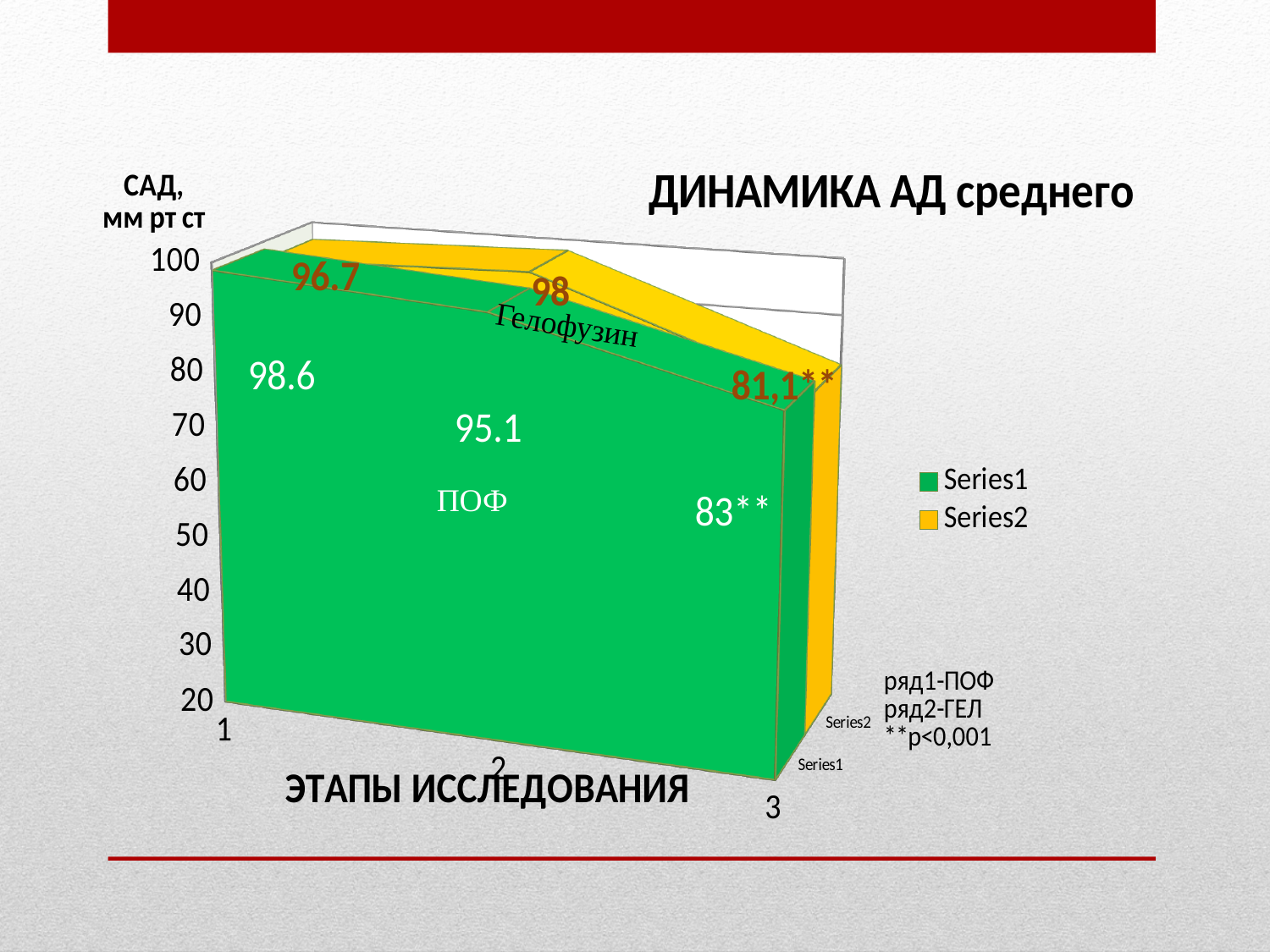
What is the difference between Series1 at stage 1 and Series1 at stage 2? 3.5 Which is larger at stage 2: Series1 or Series2? Series2 What is the value of Series1 at stage 2? 95.1 How many stages are shown on the x axis? 3 What is the value of Series2 at stage 1? 96.7 What value is labelled for Series1 at stage 3? 83** At which stage is Series1 highest? 1 How many series does the legend list? 2 What is the value of Series1 at stage 1? 98.6 What is the value of Series2 at stage 2? 98 Do the Series1 values rise or fall from stage 1 to stage 3? fall At which stage is Series2 lowest? 3